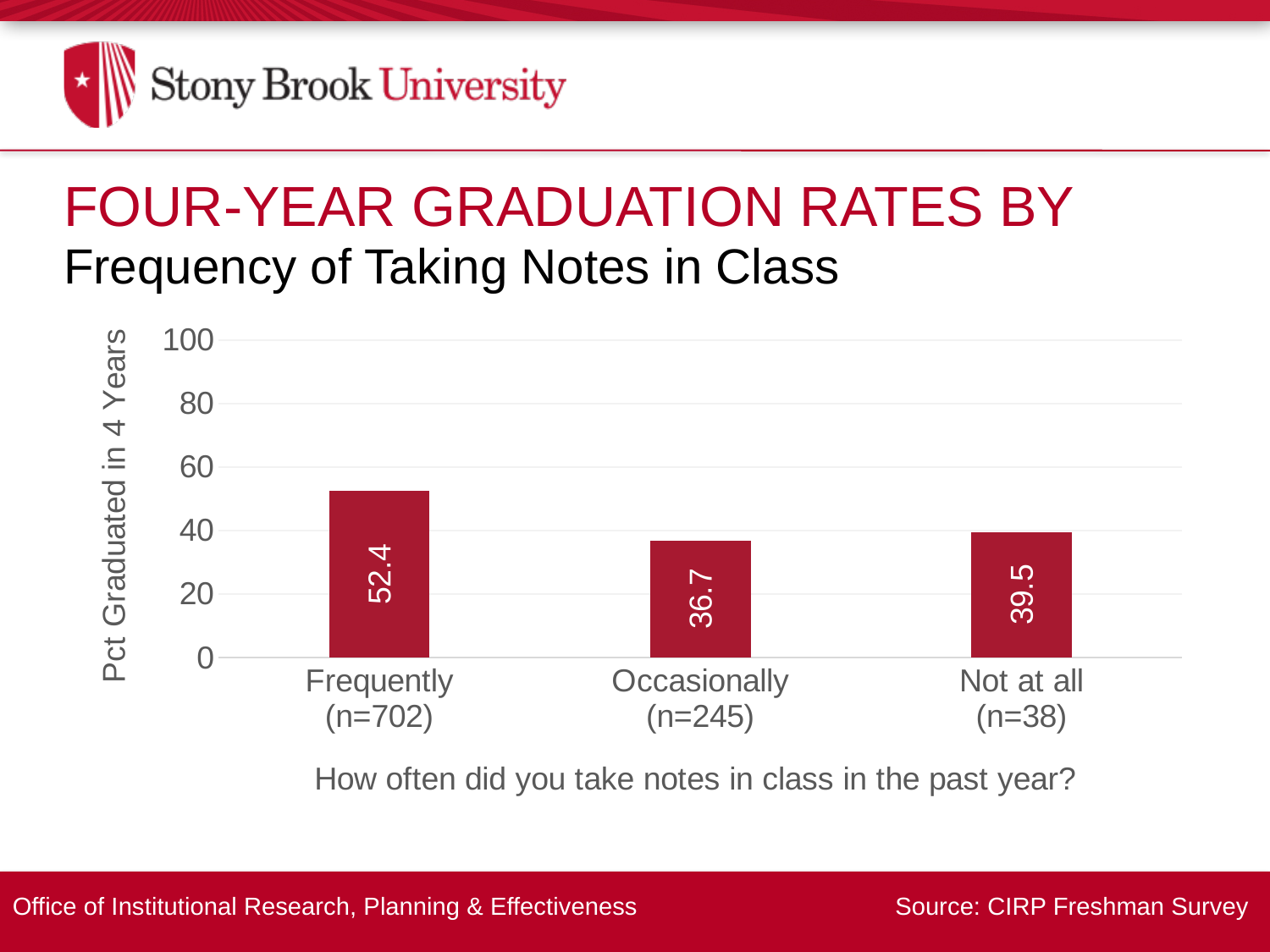
What is the sample size (n) for the Occasionally category? 245 Is the four-year graduation rate for the Frequently category greater or less than 40? greater What is the label of the vertical axis? Pct Graduated in 4 Years What kind of chart is shown on the slide? Bar chart What is the four-year graduation rate for students who took notes Not at all? 39.5 Which note-taking frequency category has the lowest four-year graduation rate? Occasionally What is the four-year graduation rate for students who took notes Occasionally? 36.7 Which note-taking frequency category has the highest four-year graduation rate? Frequently How many note-taking frequency categories are shown on the chart? 3 What is the difference in four-year graduation rate between the Frequently and Occasionally categories? 15.7 Which has a higher four-year graduation rate: Not at all or Occasionally? Not at all What is the four-year graduation rate for students who took notes in class Frequently? 52.4